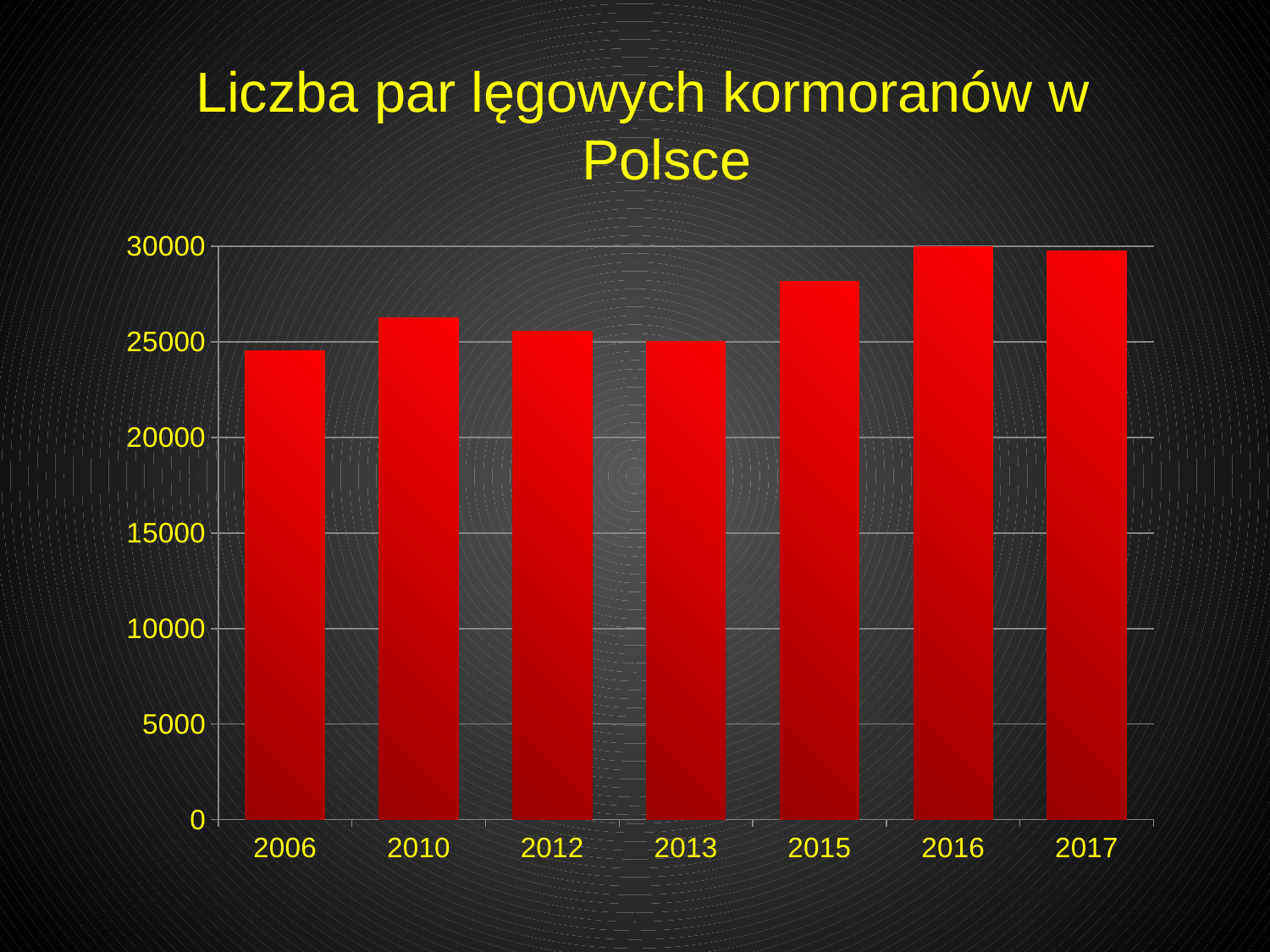
Is the value for 2010 greater or less than 25000? greater What colour are the bars on the chart? red Is the value for 2006 greater or less than 25000? less Is the value for 2015 greater or less than 30000? less Which is larger, the value for 2016 or the value for 2012? 2016 Which is larger, the value for 2015 or the value for 2006? 2015 Overall, do the values rise or fall from 2006 to 2017? rise What kind of chart is shown on the slide? bar chart Which year has the lowest value on the chart? 2006 What is the title of the chart? Liczba par lęgowych kormoranów w Polsce How many years (bars) are shown on the chart? 7